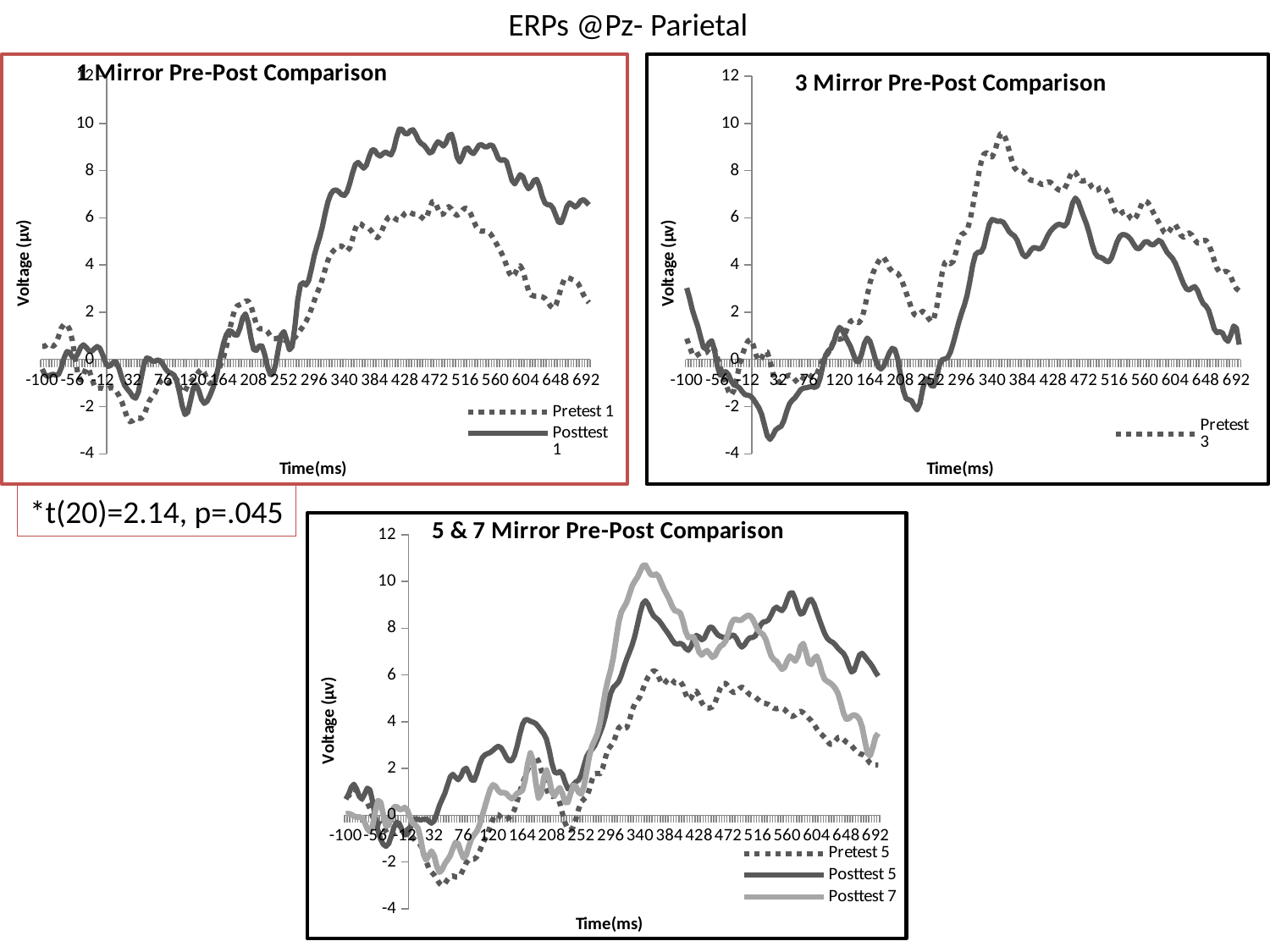
In the '1 Mirror Pre-Post Comparison' chart, is the Pretest 1 value at 428 ms greater or less than 8? less In the '5 & 7 Mirror Pre-Post Comparison' chart, which series has the lowest peak voltage? Pretest 5 What kind of chart is the '1 Mirror Pre-Post Comparison' chart? line chart What is the x-axis label on the '5 & 7 Mirror Pre-Post Comparison' chart? Time(ms) In the '1 Mirror Pre-Post Comparison' chart, which series reaches the higher peak voltage, Pretest 1 or Posttest 1? Posttest 1 In the '5 & 7 Mirror Pre-Post Comparison' chart, is the Posttest 7 value at 340 ms greater or less than 8? greater How many series does the legend of the '1 Mirror Pre-Post Comparison' chart list? 2 In the '3 Mirror Pre-Post Comparison' chart, is the dotted Pretest 3 value at 340 ms greater or less than 8? greater How many series does the legend of the '5 & 7 Mirror Pre-Post Comparison' chart list? 3 What is the y-axis label on the '3 Mirror Pre-Post Comparison' chart? Voltage (μv)